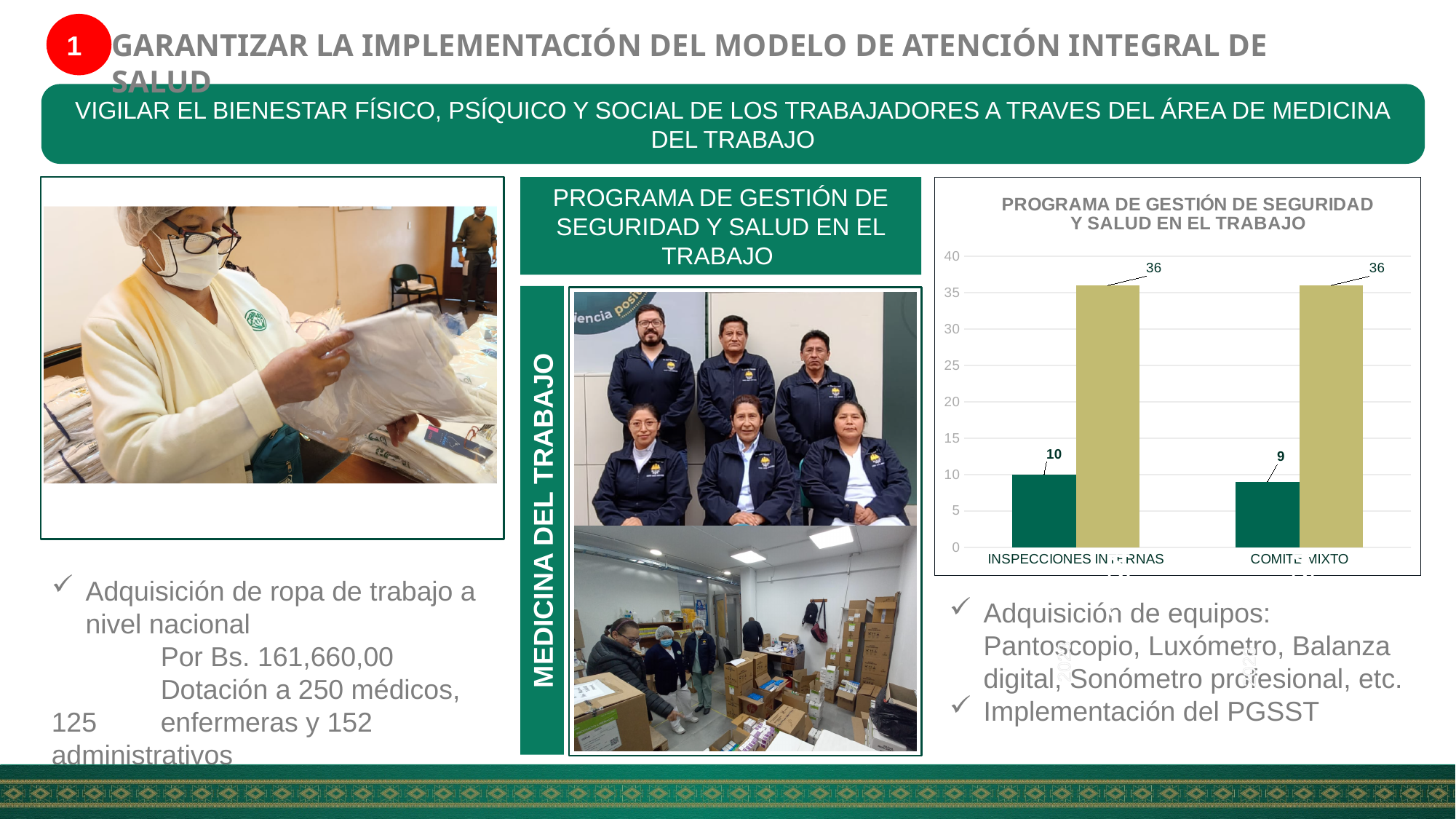
What is the highest value shown on the chart's vertical axis? 40 What is the value of the dark green bar for COMITÉ MIXTO? 9 Is the dark green bar for COMITÉ MIXTO greater or less than 10? less What kind of chart is shown on the slide? bar chart What is the difference between the tan bar and the dark green bar for COMITÉ MIXTO? 27 Which category has the higher dark green bar, INSPECCIONES INTERNAS or COMITÉ MIXTO? INSPECCIONES INTERNAS What is the value of the dark green bar for INSPECCIONES INTERNAS? 10 What is the value of the tan bar for INSPECCIONES INTERNAS? 36 What is the title of the chart? PROGRAMA DE GESTIÓN DE SEGURIDAD Y SALUD EN EL TRABAJO How many categories are shown on the x axis of the chart? 2 What is the difference between the tan bar and the dark green bar for INSPECCIONES INTERNAS? 26 What is the value of the tan bar for COMITÉ MIXTO? 36